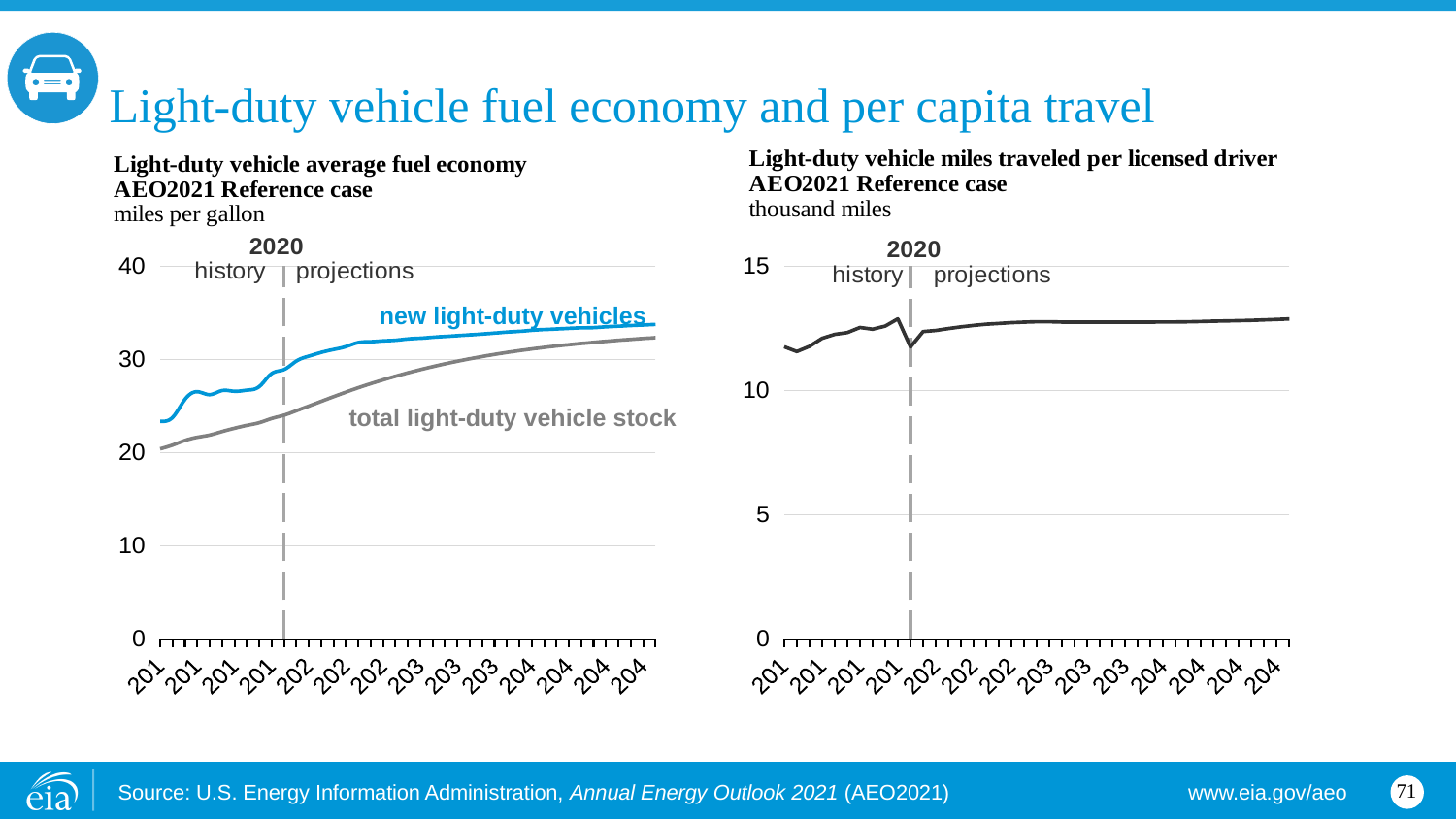
In the left chart, 'Light-duty vehicle average fuel economy', does the total light-duty vehicle stock line rise or fall along the x axis? rise In both charts, which year marks the boundary between history and projections? 2020 In the left chart, 'Light-duty vehicle average fuel economy', is the value for total light-duty vehicle stock at the start of the history period greater or less than 30? less In the left chart, 'Light-duty vehicle average fuel economy', is the value for new light-duty vehicles at the end of the projection period greater or less than 30? greater In the left chart, 'Light-duty vehicle average fuel economy', how many series are plotted? 2 In the right chart, 'Light-duty vehicle miles traveled per licensed driver', is the value at 2020 greater or less than 10? greater What kind of chart is the right chart, 'Light-duty vehicle miles traveled per licensed driver'? line chart In the left chart, 'Light-duty vehicle average fuel economy', does the new light-duty vehicles line rise or fall over the projection period? rise What unit is used on the y axis of the left chart, 'Light-duty vehicle average fuel economy'? miles per gallon What kind of chart is the left chart, 'Light-duty vehicle average fuel economy'? line chart In the left chart, 'Light-duty vehicle average fuel economy', which series is higher at 2020: new light-duty vehicles or total light-duty vehicle stock? new light-duty vehicles